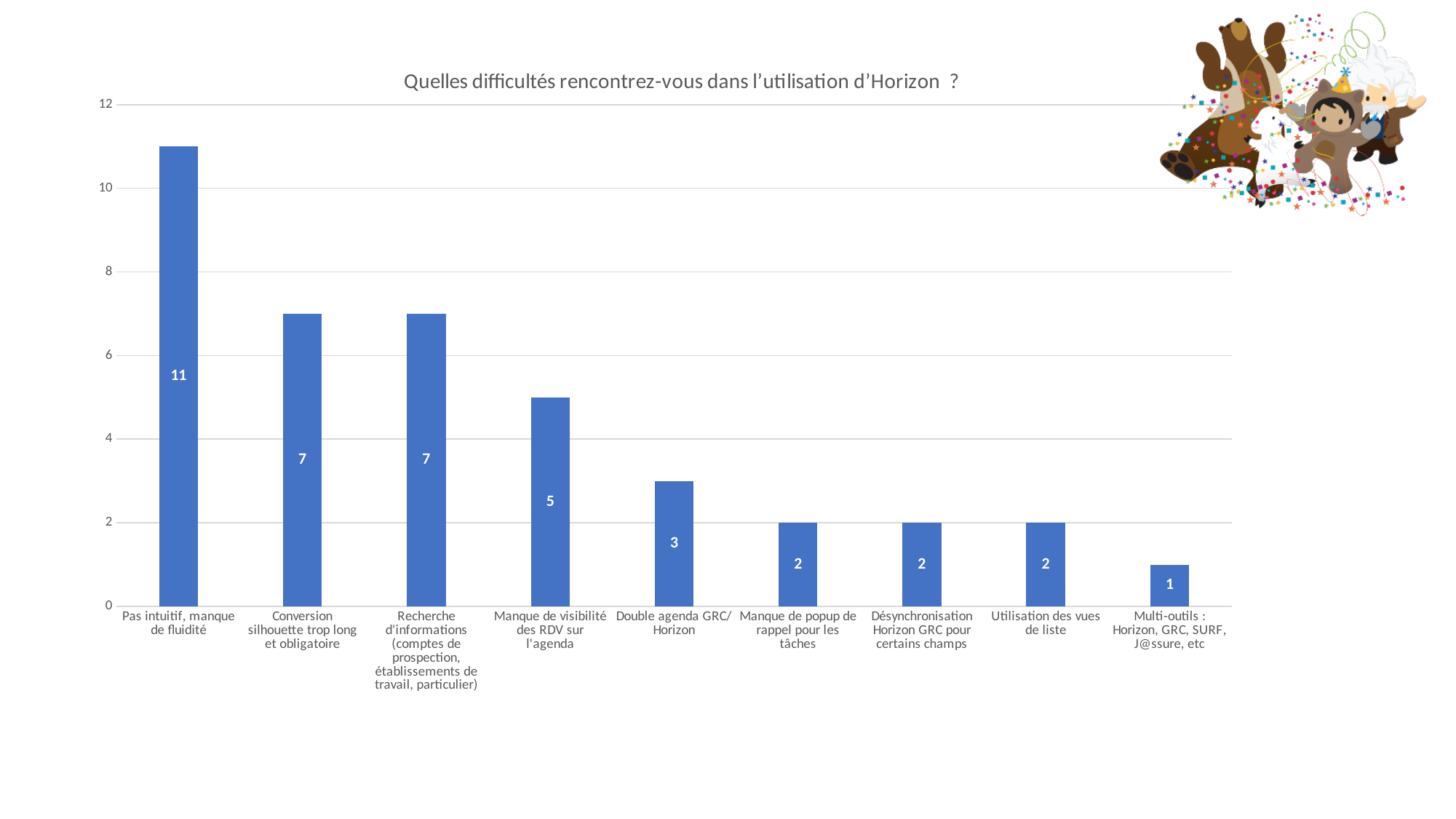
Which category has the lowest value? Multi-outils : Horizon, GRC, SURF, J@ssure, etc How many categories are shown on the chart? 9 Is the value for "Pas intuitif, manque de fluidité" greater or less than 10? greater What is the value for "Manque de visibilité des RDV sur l'agenda"? 5 Which is larger: the value for "Manque de visibilité des RDV sur l'agenda" or the value for "Double agenda GRC/ Horizon"? Manque de visibilité des RDV sur l'agenda Which category has the highest value? Pas intuitif, manque de fluidité What is the title of the chart? Quelles difficultés rencontrez-vous dans l'utilisation d'Horizon ? What is the value for "Double agenda GRC/ Horizon"? 3 What kind of chart is shown on the slide? bar chart What is the value for "Pas intuitif, manque de fluidité"? 11 What is the value for "Multi-outils : Horizon, GRC, SURF, J@ssure, etc"? 1 What is the difference between the values for "Pas intuitif, manque de fluidité" and "Conversion silhouette trop long et obligatoire"? 4